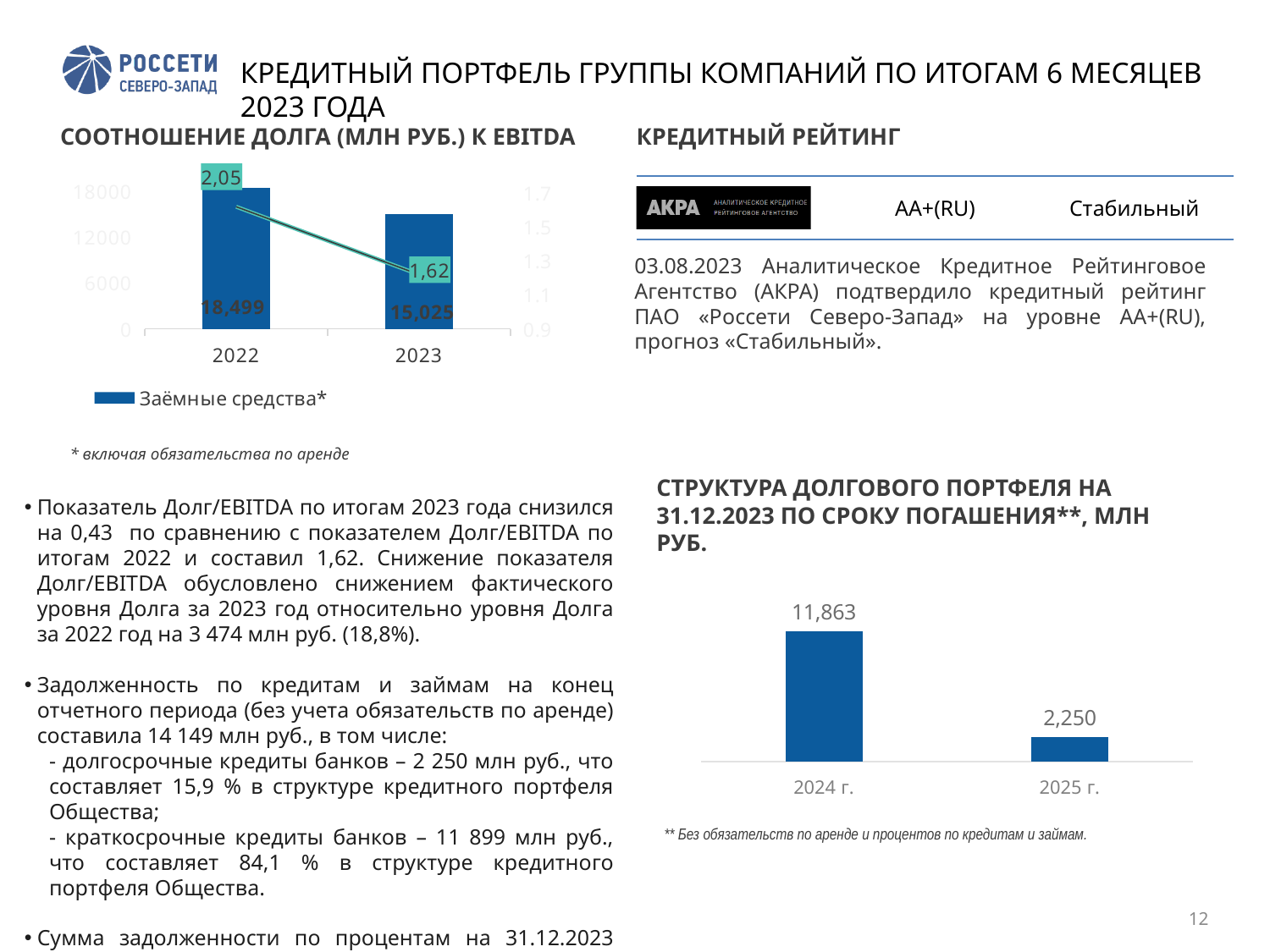
In the chart 'СТРУКТУРА ДОЛГОВОГО ПОРТФЕЛЯ НА 31.12.2023 ПО СРОКУ ПОГАШЕНИЯ', what is the value for 2025 г.? 2,250 What type of chart is 'СТРУКТУРА ДОЛГОВОГО ПОРТФЕЛЯ НА 31.12.2023 ПО СРОКУ ПОГАШЕНИЯ'? bar chart In the chart 'СООТНОШЕНИЕ ДОЛГА (МЛН РУБ.) К EBITDA', what is the value of Заёмные средства for 2022? 18,499 In the chart 'СТРУКТУРА ДОЛГОВОГО ПОРТФЕЛЯ НА 31.12.2023 ПО СРОКУ ПОГАШЕНИЯ', which year has the higher value? 2024 г. In the chart 'СТРУКТУРА ДОЛГОВОГО ПОРТФЕЛЯ НА 31.12.2023 ПО СРОКУ ПОГАШЕНИЯ', what is the value for 2024 г.? 11,863 In the chart 'СТРУКТУРА ДОЛГОВОГО ПОРТФЕЛЯ НА 31.12.2023 ПО СРОКУ ПОГАШЕНИЯ', what is the difference between the 2024 г. and 2025 г. values? 9,613 In the chart 'СООТНОШЕНИЕ ДОЛГА (МЛН РУБ.) К EBITDA', what is the Debt/EBITDA ratio shown on the line for 2023? 1,62 In the chart 'СООТНОШЕНИЕ ДОЛГА (МЛН РУБ.) К EBITDA', what series name does the legend show? Заёмные средства* In the chart 'СООТНОШЕНИЕ ДОЛГА (МЛН РУБ.) К EBITDA', what is the value of Заёмные средства for 2023? 15,025 In the chart 'СООТНОШЕНИЕ ДОЛГА (МЛН РУБ.) К EBITDA', what is the Debt/EBITDA ratio shown on the line for 2022? 2,05 In the chart 'СООТНОШЕНИЕ ДОЛГА (МЛН РУБ.) К EBITDA', does the Debt/EBITDA line rise or fall from 2022 to 2023? fall In the chart 'СООТНОШЕНИЕ ДОЛГА (МЛН РУБ.) К EBITDA', by how much did Заёмные средства decrease from 2022 to 2023? 3,474